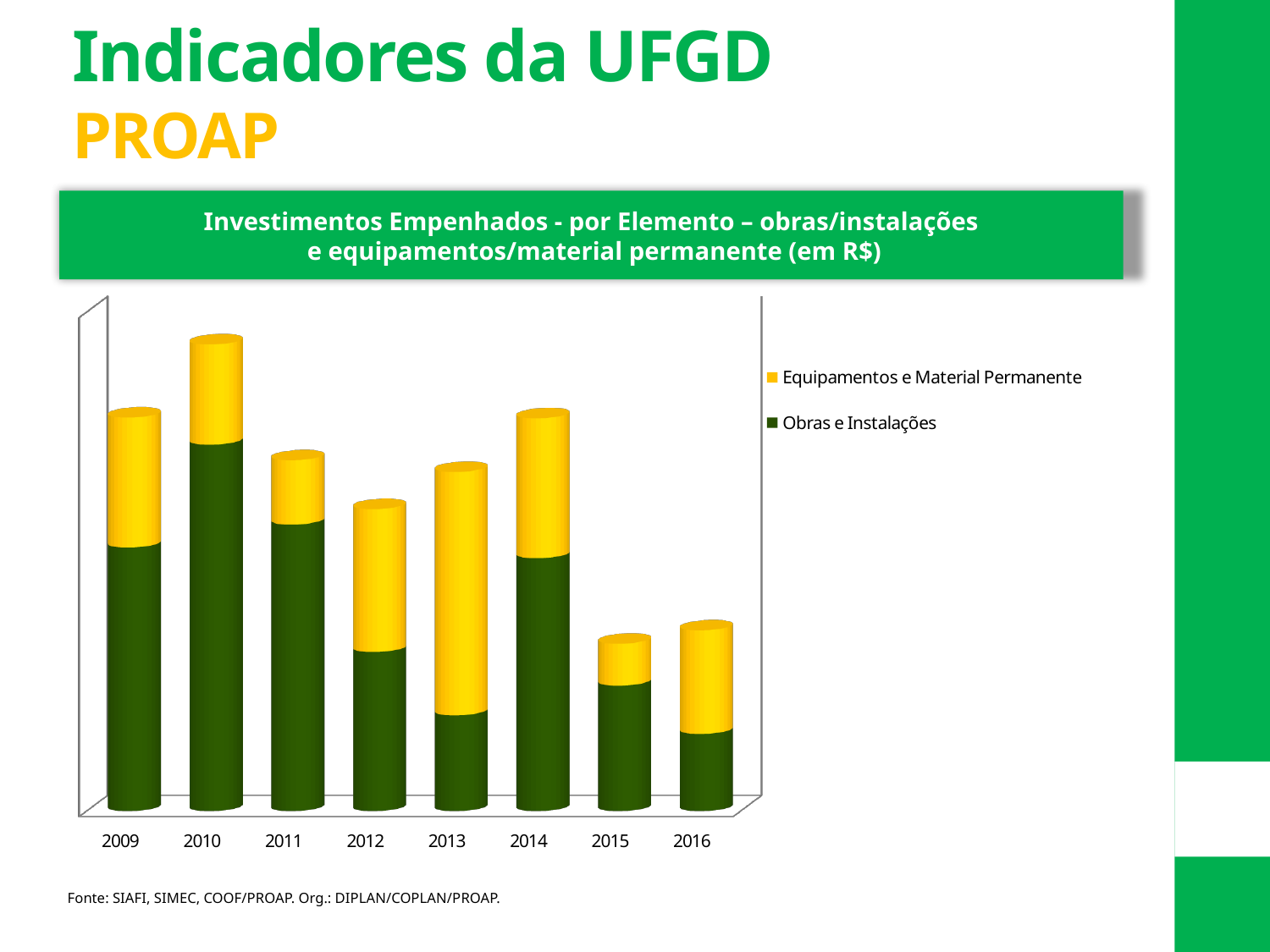
How many years are shown on the x axis of the chart? 8 Which year has the largest Equipamentos e Material Permanente segment? 2013 Which series is shown in yellow in the chart? Equipamentos e Material Permanente Which year has the largest Obras e Instalações segment? 2010 Which year has the higher total bar, 2011 or 2014? 2014 How many series does the chart legend list? 2 Which year has the highest total investment bar? 2010 What kind of chart is shown on the slide? Stacked bar chart Which year has the smallest Obras e Instalações segment? 2016 Which year has the higher total bar, 2009 or 2010? 2010 Which series is shown in dark green in the chart? Obras e Instalações